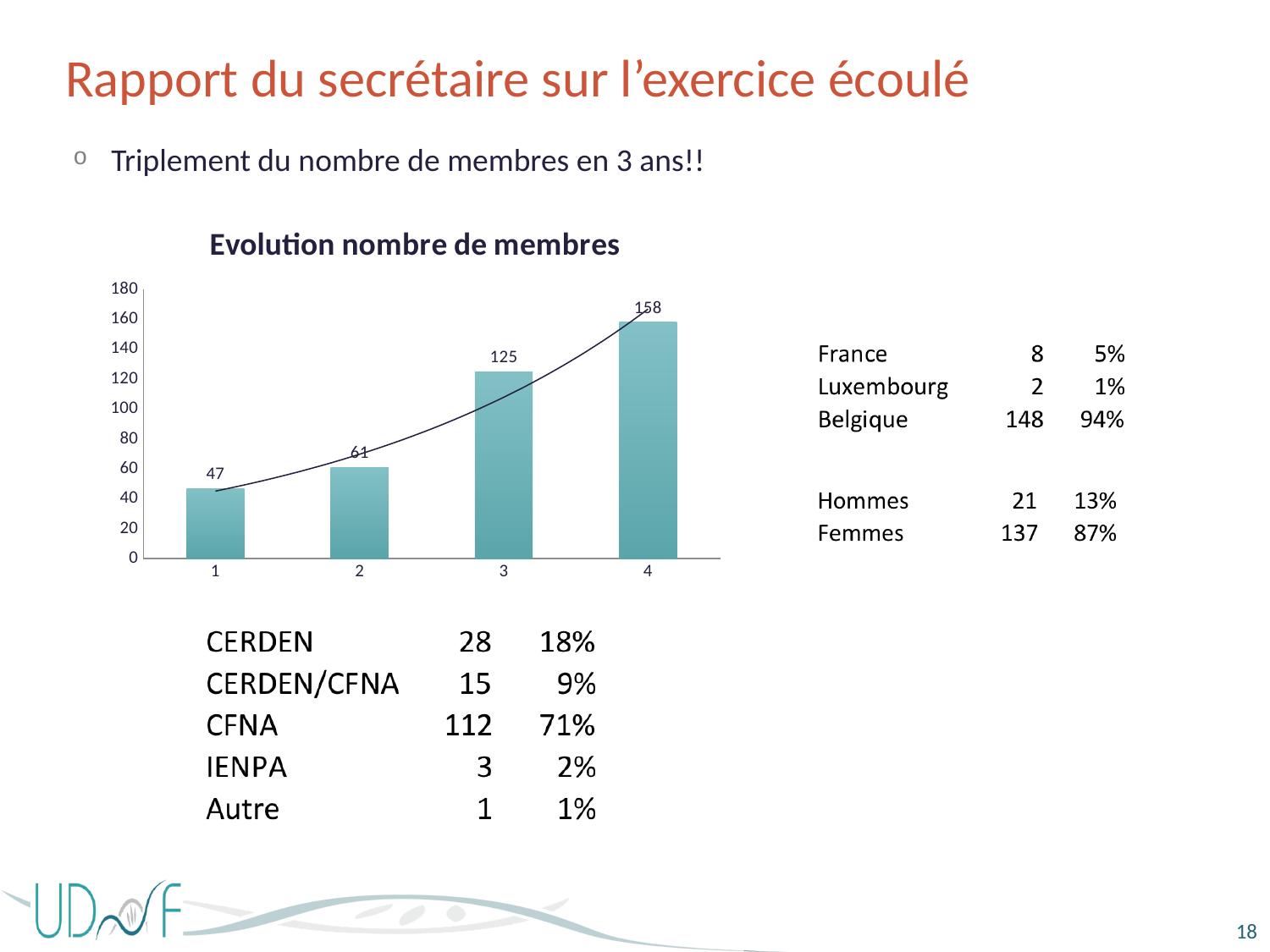
Which category has the lowest value in the 'Evolution nombre de membres' chart? 1 Do the values in the 'Evolution nombre de membres' chart rise or fall from category 1 to category 4? rise What is the difference between the values for category 4 and category 1 in the 'Evolution nombre de membres' chart? 111 Is the value for category 3 in the 'Evolution nombre de membres' chart greater or less than 100? greater What is the value for category 4 in the 'Evolution nombre de membres' chart? 158 What is the difference between the values for category 3 and category 2 in the 'Evolution nombre de membres' chart? 64 What is the value for category 3 in the 'Evolution nombre de membres' chart? 125 Which is larger in the 'Evolution nombre de membres' chart, the value for category 2 or category 3? 3 How many bars are shown in the 'Evolution nombre de membres' chart? 4 Which category has the highest value in the 'Evolution nombre de membres' chart? 4 What is the value for category 1 in the 'Evolution nombre de membres' chart? 47 What kind of chart is 'Evolution nombre de membres'? bar chart